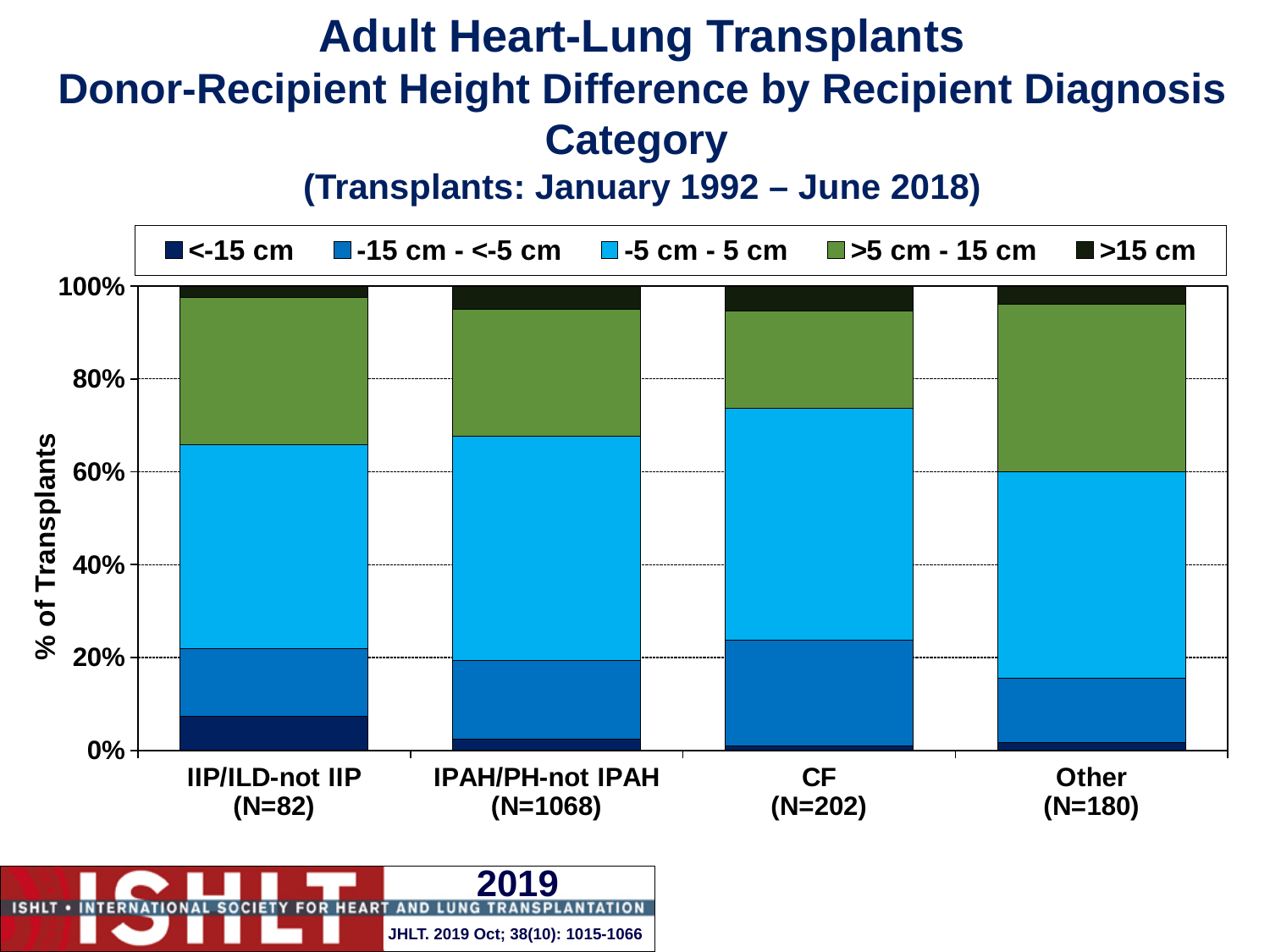
Which diagnosis category has the largest -15 cm - <-5 cm segment? CF How many recipient diagnosis categories are shown on the x axis? 4 Is the <-15 cm segment larger for IIP/ILD-not IIP or for IPAH/PH-not IPAH? IIP/ILD-not IIP What is the label of the y axis? % of Transplants Is the combined share of the <-15 cm and -15 cm - <-5 cm categories for Other greater or less than 20%? less What kind of chart is shown on the slide? Stacked bar chart Which diagnosis category has the smallest >5 cm - 15 cm segment? CF What is the N shown for the IPAH/PH-not IPAH category? N=1068 How many height-difference series does the legend list? 5 Which diagnosis category has the largest <-15 cm segment? IIP/ILD-not IIP Is the >5 cm - 15 cm segment larger for Other or for CF? Other Is the share of the <-15 cm category for IIP/ILD-not IIP greater or less than 20%? less